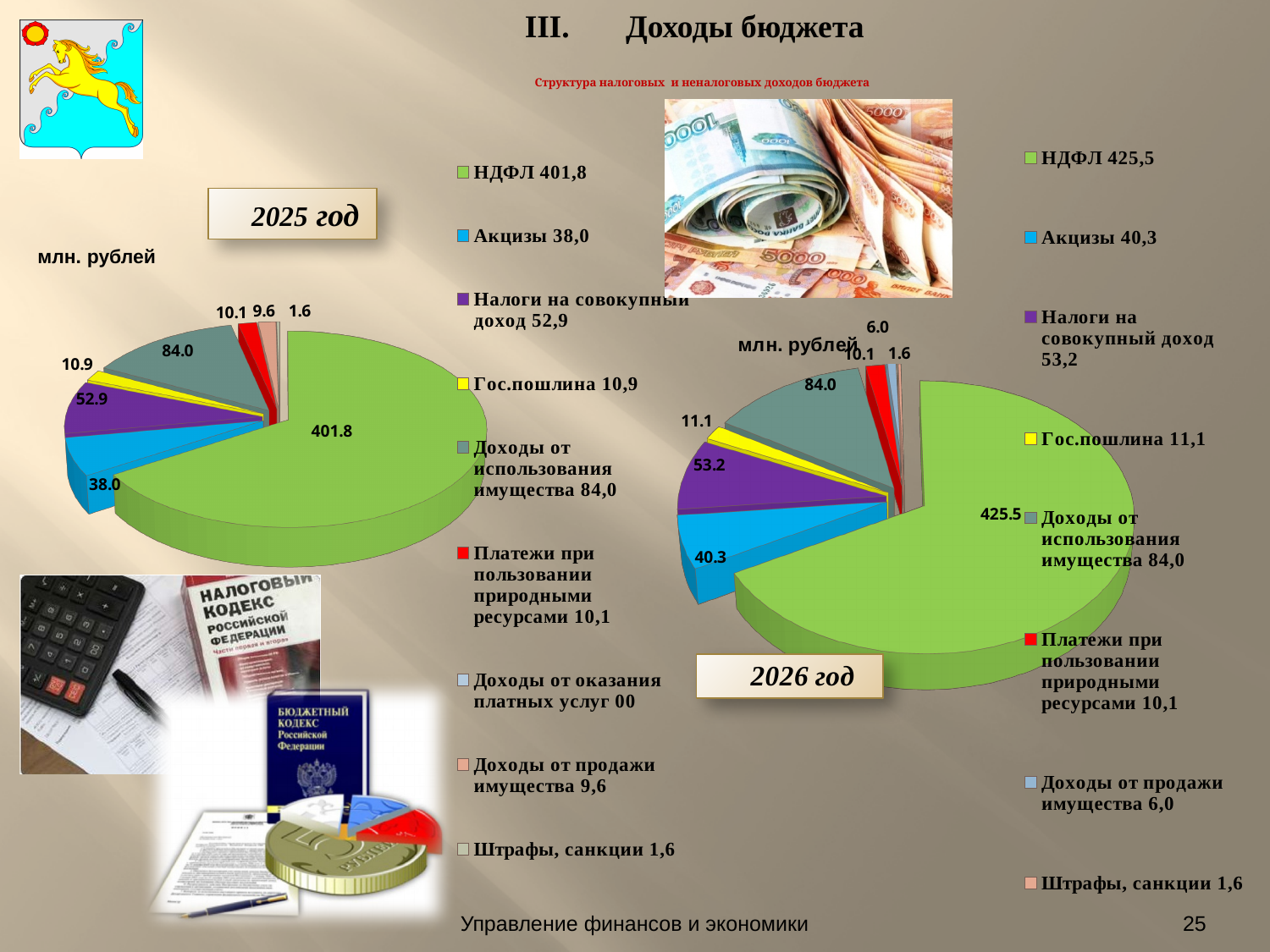
In the 2026 год chart, which category has the largest value? НДФЛ In the 2025 год chart, what is the difference between Доходы от использования имущества and Налоги на совокупный доход? 31.1 What unit is indicated for the values in the 2025 год chart? млн. рублей What type of chart is used for the 2025 год chart? pie chart How many entries does the legend of the 2026 год chart list? 8 In the 2025 год chart, what is the value for НДФЛ? 401.8 In the 2026 год chart, what is the difference between НДФЛ and Акцизы? 385.2 In the 2026 год chart, what is the value for Акцизы? 40.3 In the 2026 год chart, which category has the smallest value? Штрафы, санкции In the 2025 год chart, what is the value for Доходы от продажи имущества? 9.6 In the 2025 год chart, which is larger: Акцизы or Налоги на совокупный доход? Налоги на совокупный доход In the 2026 год chart, what is the value for Налоги на совокупный доход? 53.2